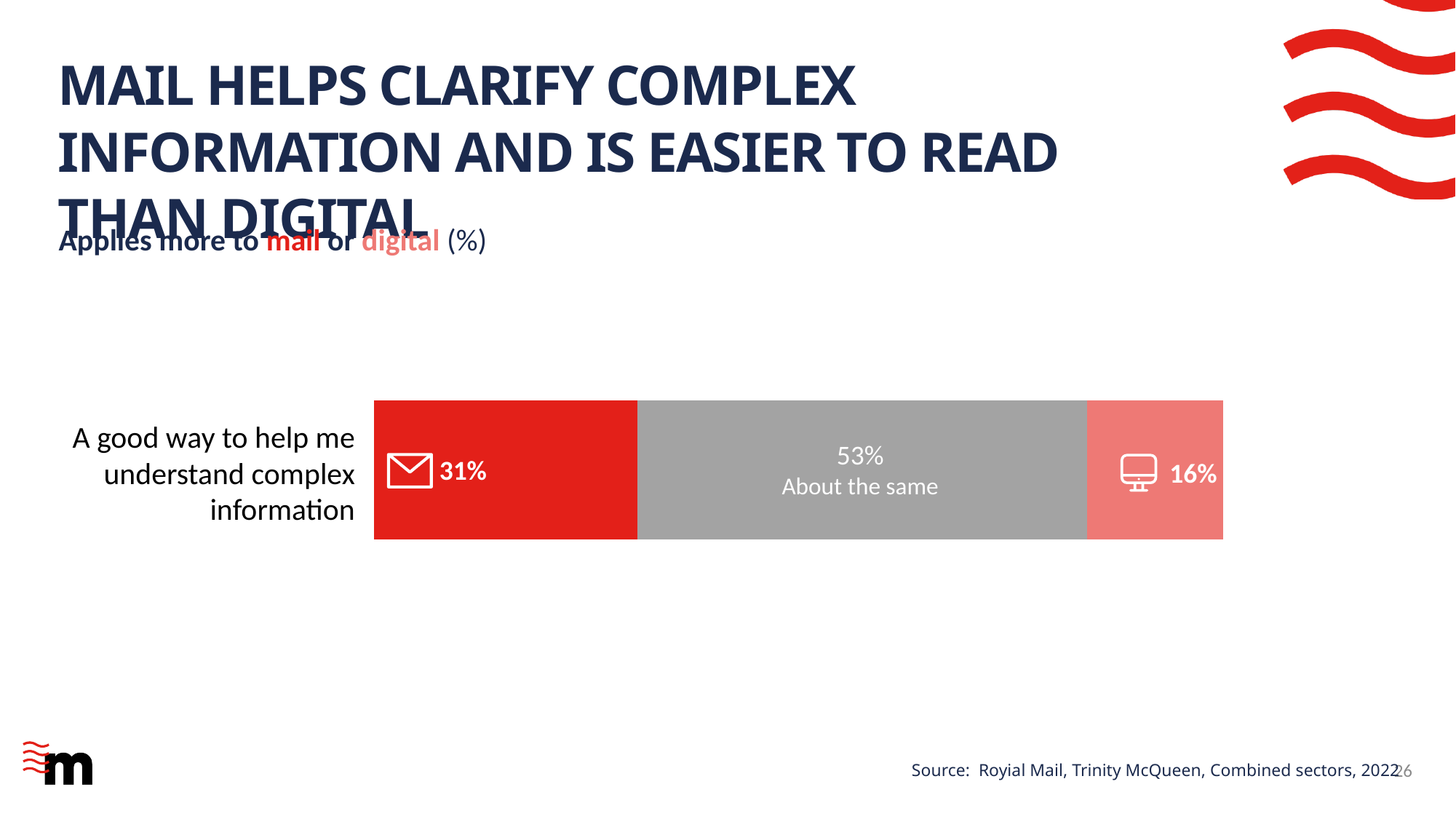
What kind of chart is shown on the slide? Stacked horizontal bar chart What is the difference between the mail percentage and the digital percentage? 15 percentage points Which is larger, the percentage for mail or the percentage for digital? Mail What percentage of respondents said mail applies more for 'A good way to help me understand complex information'? 31% How many segments make up the stacked bar? 3 Which segment of the bar has the largest value? About the same What is the category label for the bar shown on the slide? A good way to help me understand complex information What is the total of the three segments in the stacked bar? 100% What percentage of respondents said digital applies more for 'A good way to help me understand complex information'? 16% What colour is the segment representing 'About the same'? Grey Which segment of the bar has the smallest value? Digital (16%) What percentage of respondents said 'About the same' for 'A good way to help me understand complex information'? 53%